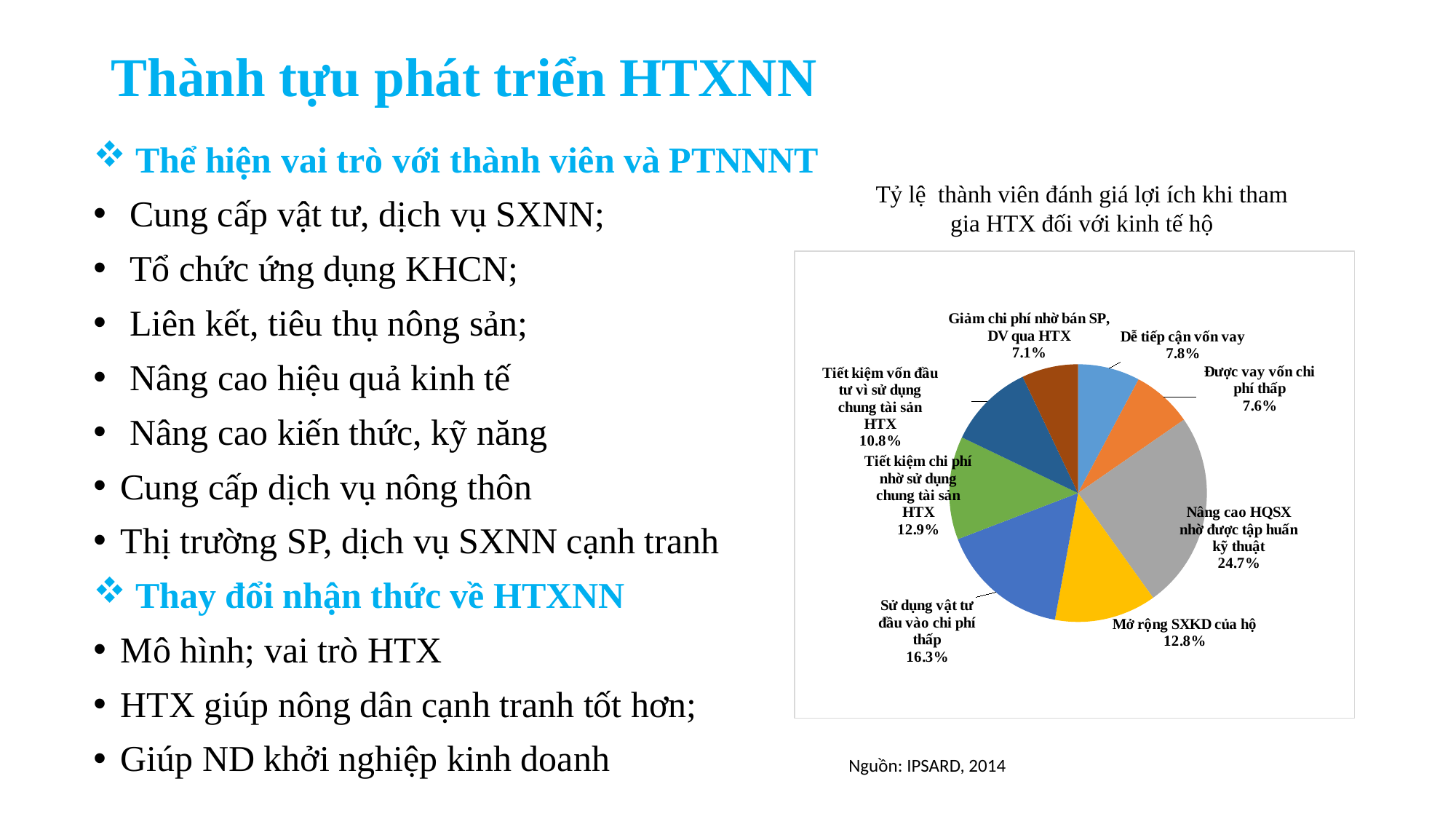
Which is larger: 'Tiết kiệm chi phí nhờ sử dụng chung tài sản HTX' or 'Tiết kiệm vốn đầu tư vì sử dụng chung tài sản HTX'? Tiết kiệm chi phí nhờ sử dụng chung tài sản HTX How many slices does the pie chart have? 8 Which category has the largest share in the pie chart? Nâng cao HQSX nhờ được tập huấn kỹ thuật What is the value shown for 'Tiết kiệm vốn đầu tư vì sử dụng chung tài sản HTX'? 10.8% Which category has the smallest share in the pie chart? Giảm chi phí nhờ bán SP, DV qua HTX What is the value shown for 'Dễ tiếp cận vốn vay'? 7.8% What is the difference between 'Nâng cao HQSX nhờ được tập huấn kỹ thuật' and 'Sử dụng vật tư đầu vào chi phí thấp'? 8.4% What kind of chart is shown on the slide? Pie chart What is the title of the pie chart? Tỷ lệ thành viên đánh giá lợi ích khi tham gia HTX đối với kinh tế hộ What is the value shown for 'Mở rộng SXKD của hộ'? 12.8% What share of the pie is 'Sử dụng vật tư đầu vào chi phí thấp'? 16.3% What source is cited for the chart? IPSARD, 2014